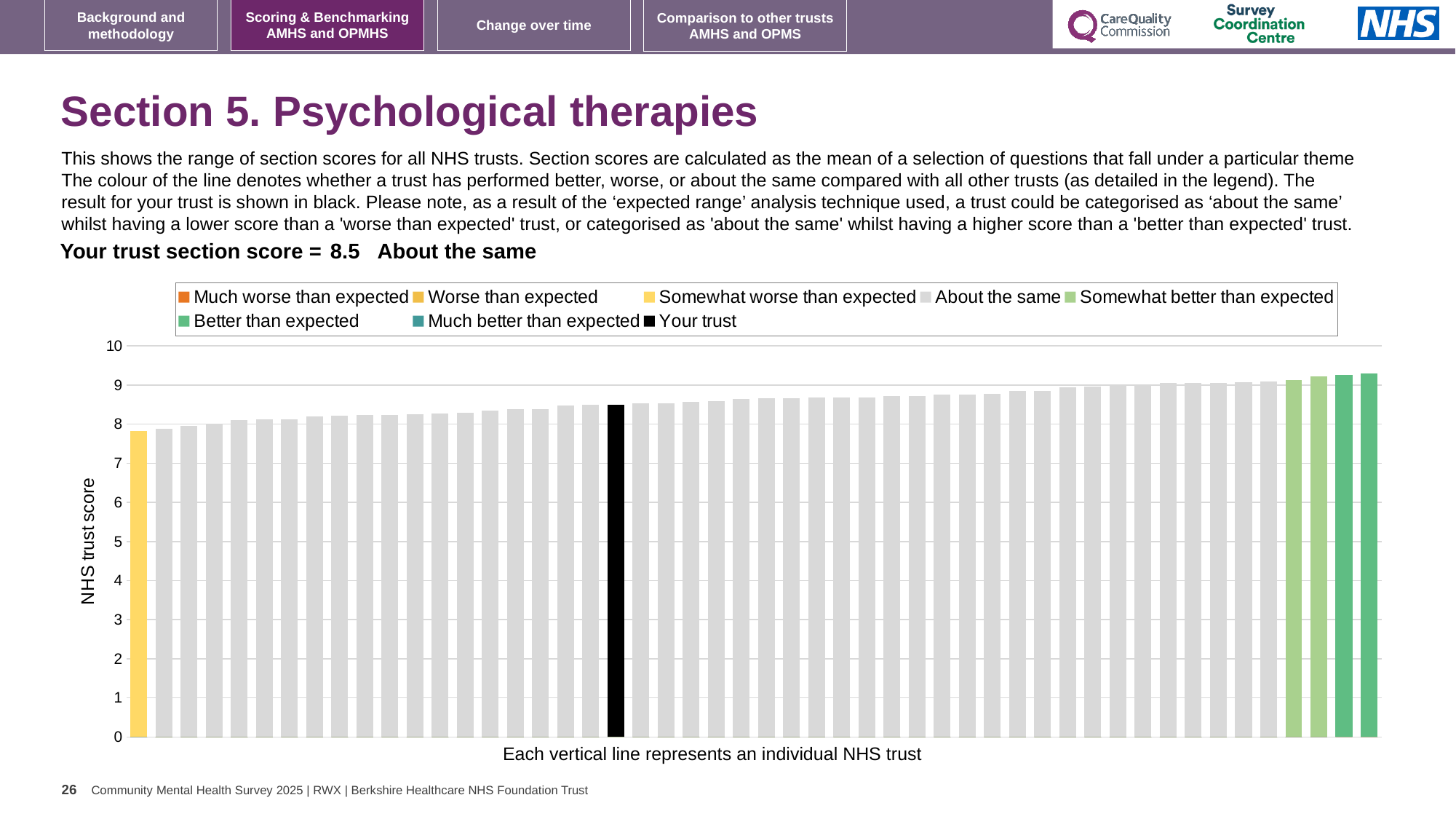
What kind of chart is shown on the slide? bar chart Which category is your trust placed in for this section? About the same Do the bar values rise or fall from left to right along the x axis? rise What is your trust's section score for Psychological therapies? 8.5 Is the value of the highest bar greater or less than 9? greater How many entries does the chart legend list? 8 What colour is the bar representing your trust? black Is the value of the lowest bar (the leftmost yellow bar) greater or less than 7? greater How many bars are coloured green (somewhat better or better than expected)? 4 What is the label on the y axis of the chart? NHS trust score Is the value of the black bar (your trust) greater or less than 8? greater How many bars are coloured yellow (worse than expected)? 1